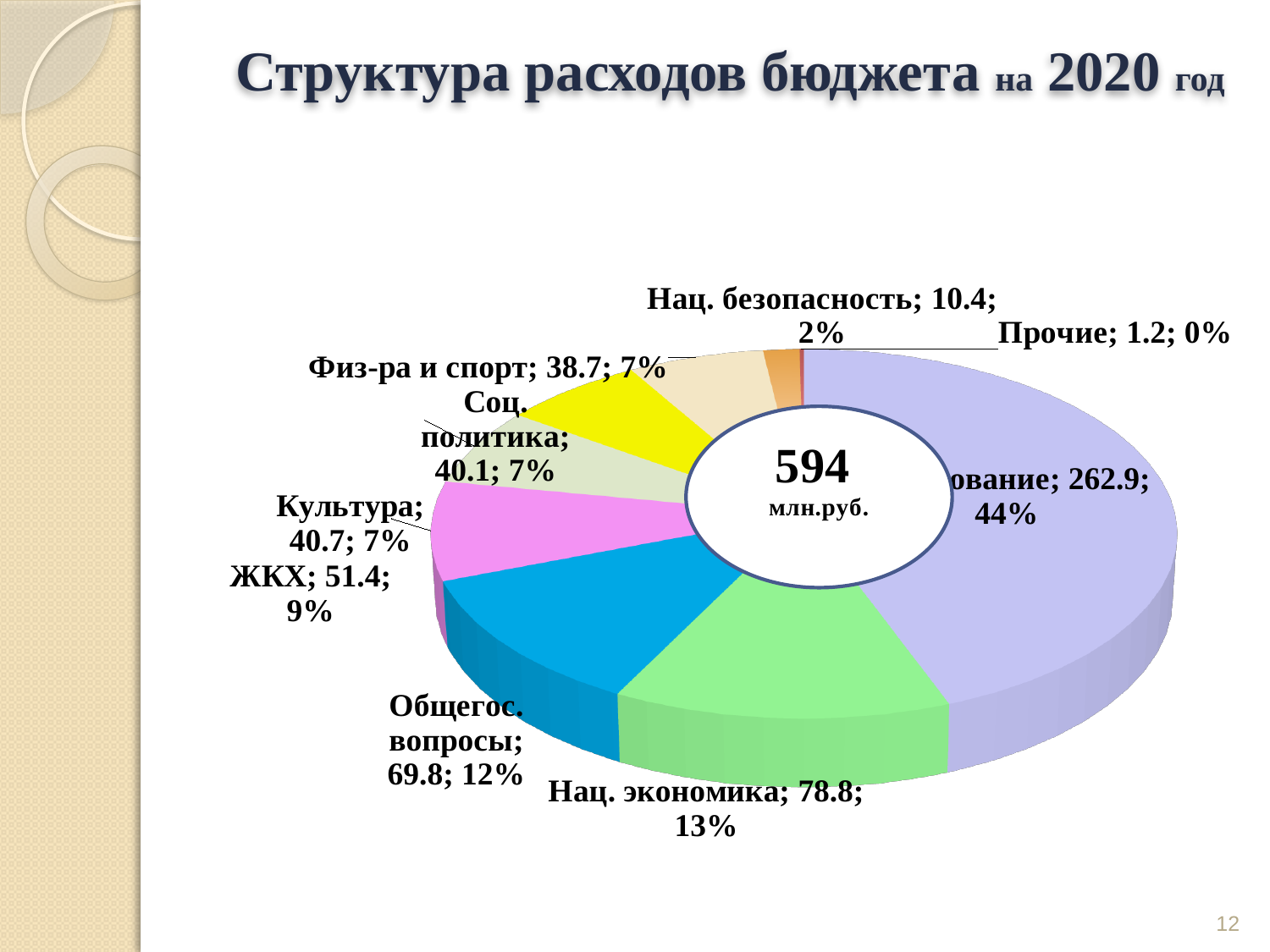
Which category has the smallest slice of the pie? Прочие What is the value shown for Нац. экономика? 78.8 What is the difference between the values for Нац. экономика and Общегос. вопросы? 9 What is the value shown for Физ-ра и спорт? 38.7 What is the value shown for Культура? 40.7 Which is larger, the value for ЖКХ or the value for Соц. политика? ЖКХ How many slices does the pie chart have? 9 What total is printed in the centre of the pie chart? 594 млн.руб. What share of the pie does Нац. безопасность account for? 2% What share of the pie does ЖКХ account for? 9% What kind of chart is shown on the slide? pie chart What is the difference between the values for ЖКХ and Культура? 10.7